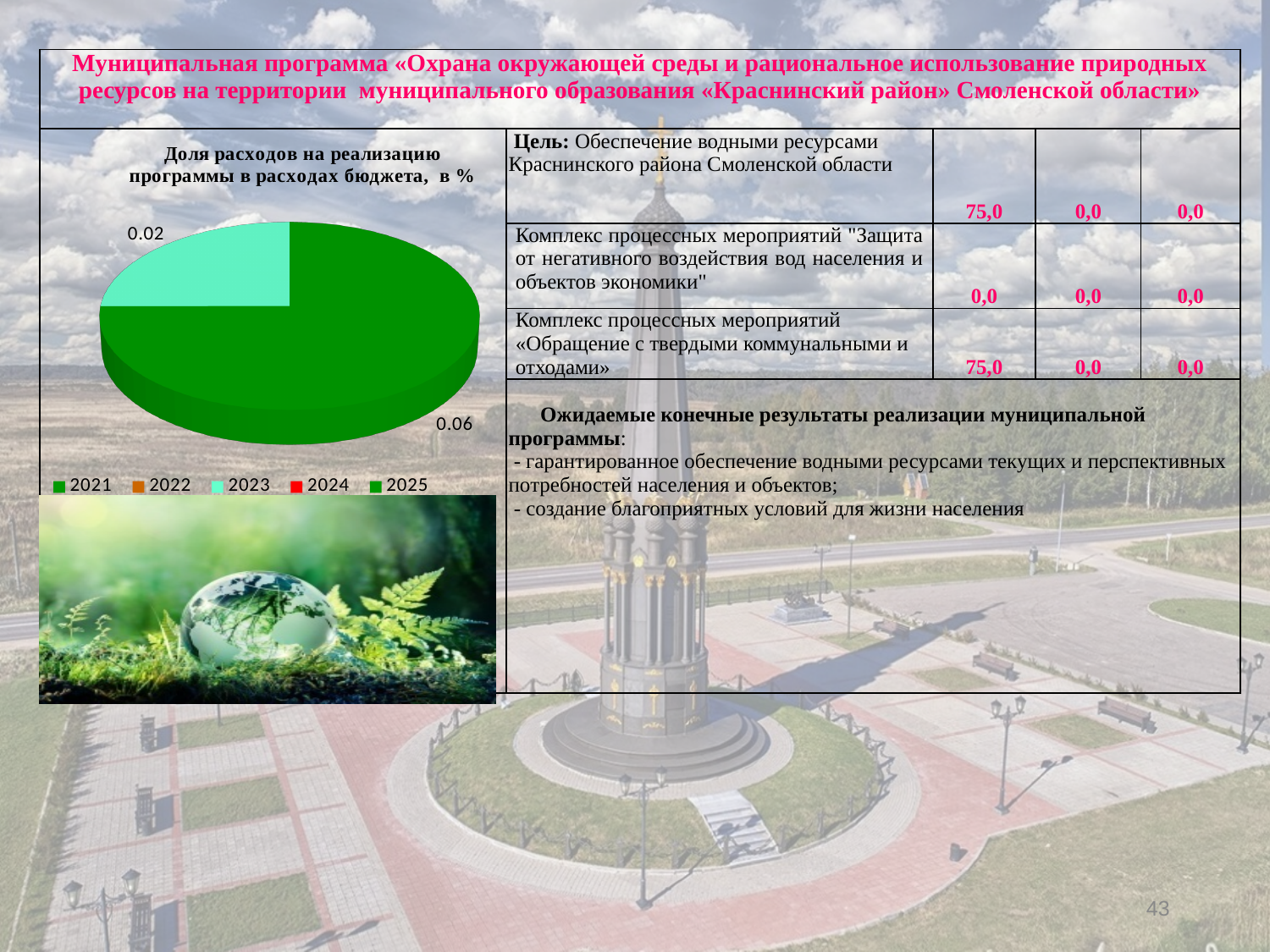
How many slices with data labels are visible in the pie chart? 2 What is the largest value labelled on the pie chart? 0.06 What is the smallest value labelled on the pie chart? 0.02 How many entries does the legend of the pie chart list? 5 What is the difference between the two labelled values on the pie chart, 0.06 and 0.02? 0.04 Which years are listed in the legend of the pie chart? 2021, 2022, 2023, 2024, 2025 What kind of chart is shown on the slide? pie chart What is the value shown for the light-coloured slice (2023) in the pie chart? 0.02 What is the title of the pie chart on the slide? Доля расходов на реализацию программы в расходах бюджета, в % Which labelled slice of the pie chart is larger, the one labelled 0.06 or the one labelled 0.02? 0.06